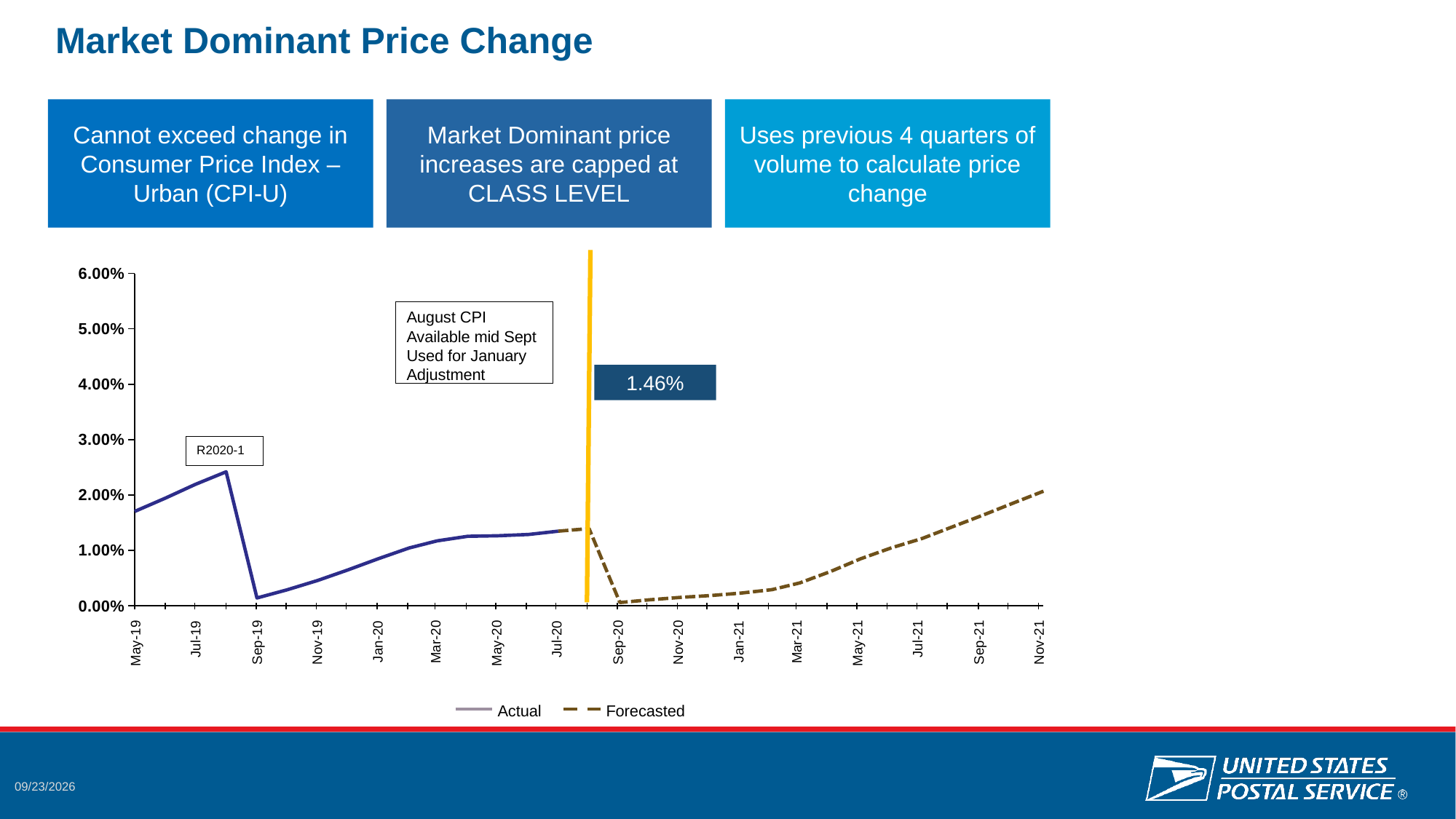
What value is printed in the highlighted box next to the vertical yellow line? 1.46% Which series is drawn with a dashed line? Forecasted Is the Actual value for Jul-19 greater or less than 2.00%? greater How many series does the chart legend list? 2 Is the Forecasted value for Sep-21 greater or less than 1.00%? greater Is the Actual value for Sep-19 greater or less than 1.00%? less How many month labels are shown on the x axis? 16 What are the two series named in the chart legend? Actual and Forecasted What type of chart is shown on the slide? Line chart Which is larger, the Actual value for Jul-19 or the Actual value for Sep-19? Jul-19 Does the Forecasted line rise or fall from Sep-20 to Nov-21? Rise